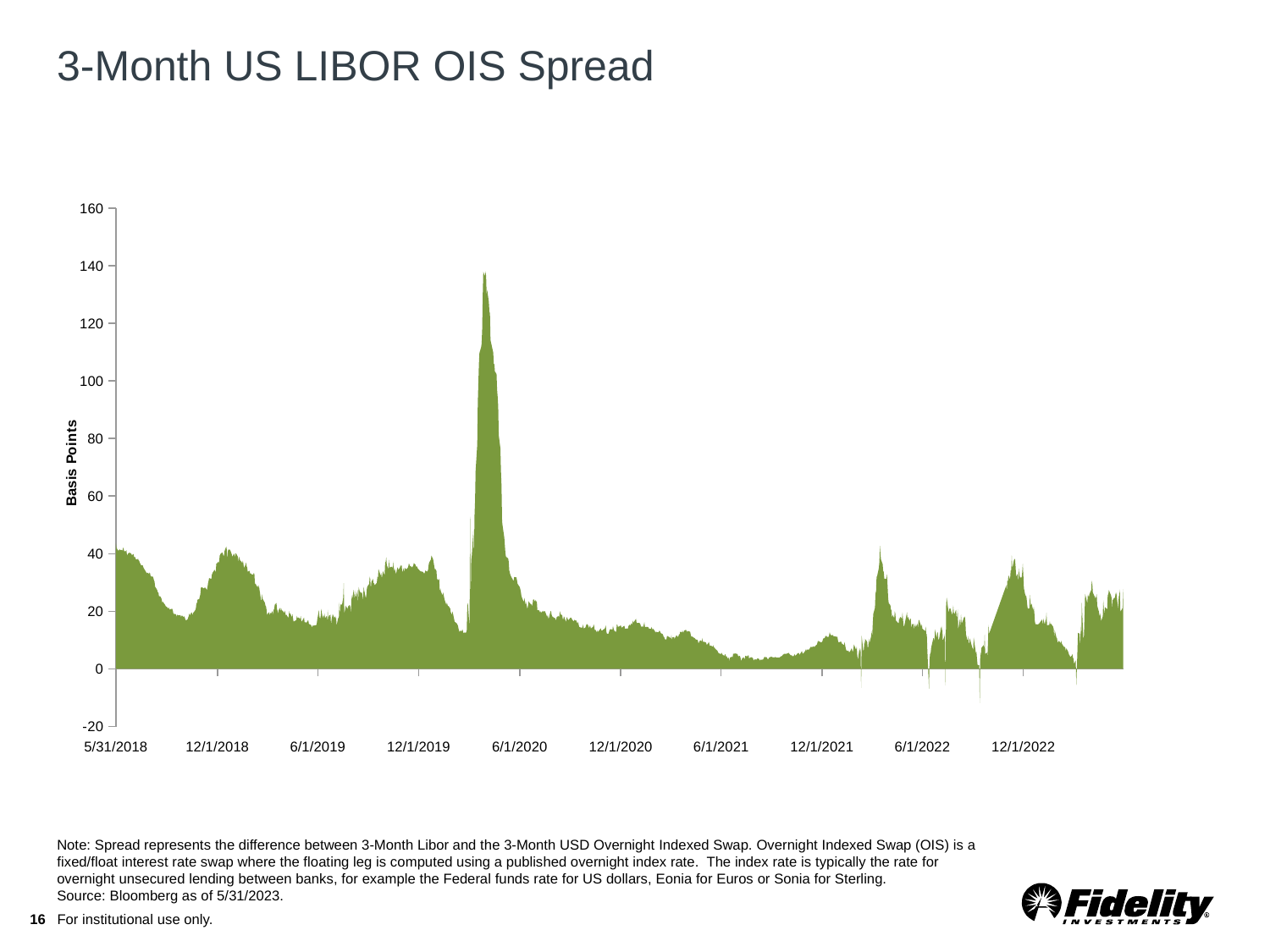
Is the spread around 12/1/2021 greater or less than 40 basis points? less Is the value of the spread at 5/31/2018 greater or less than 20 basis points? greater Is the value of the spread around 6/1/2021 greater or less than 20 basis points? less What is the title of the chart? 3-Month US LIBOR OIS Spread What kind of chart is shown on the slide? Area chart What is the highest tick value shown on the vertical axis? 160 How many date labels are shown on the x axis? 10 Between which two x-axis date labels does the highest spike in the spread occur? 12/1/2019 and 6/1/2020 What is the label on the vertical axis of the chart? Basis Points